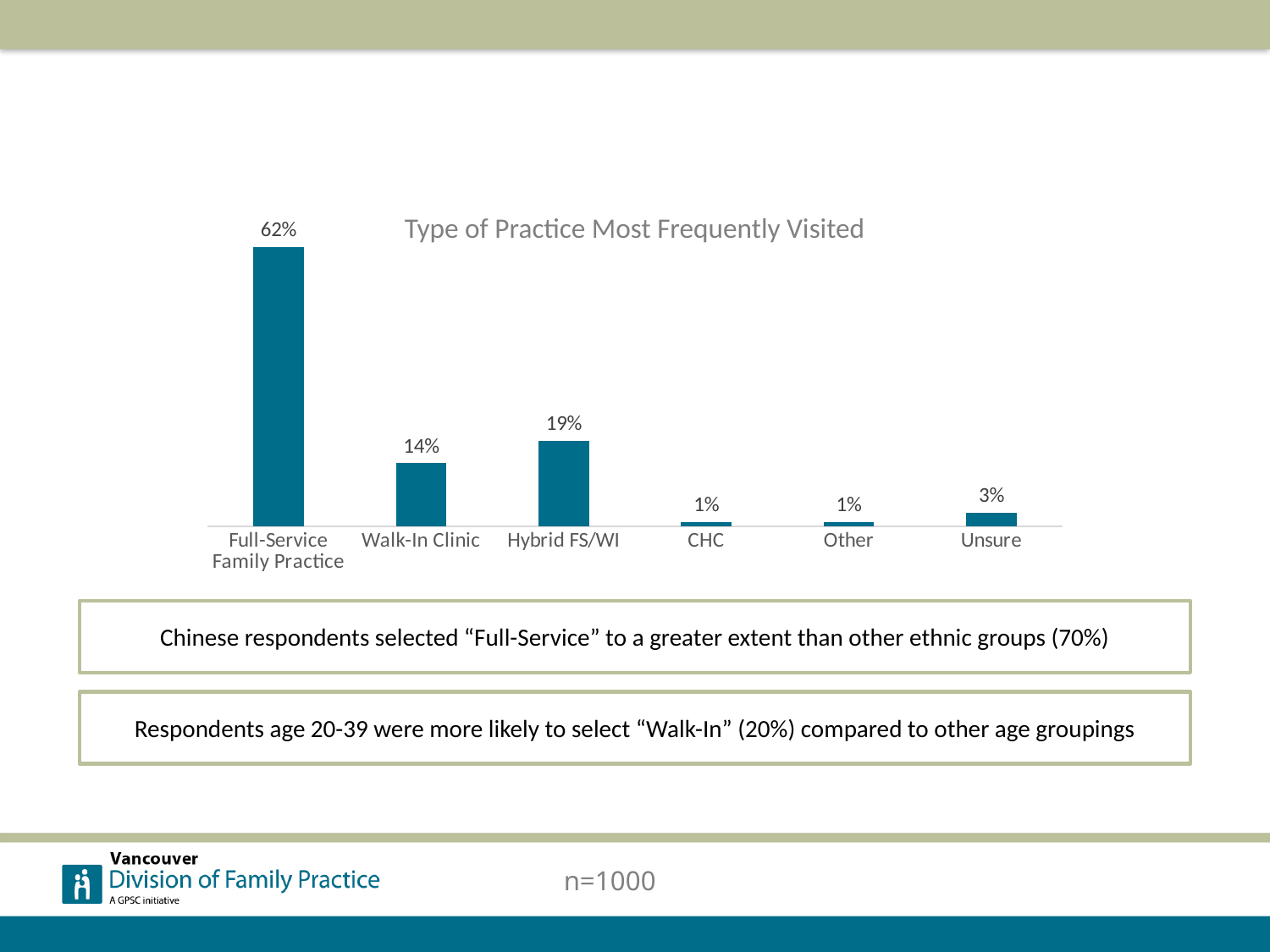
What is the value for Hybrid FS/WI? 19% How many categories are shown on the x axis? 6 What is the value for Walk-In Clinic? 14% Which is larger, the value for Walk-In Clinic or the value for Hybrid FS/WI? Hybrid FS/WI What kind of chart is shown on the slide? Bar chart What is the value for Unsure? 3% Which category has the highest value? Full-Service Family Practice Which is larger, the value for Unsure or the value for CHC? Unsure What is the value for Full-Service Family Practice? 62% What is the difference between the values for Full-Service Family Practice and Hybrid FS/WI? 43% What is the difference between the values for Hybrid FS/WI and Walk-In Clinic? 5% What is the title of the chart? Type of Practice Most Frequently Visited